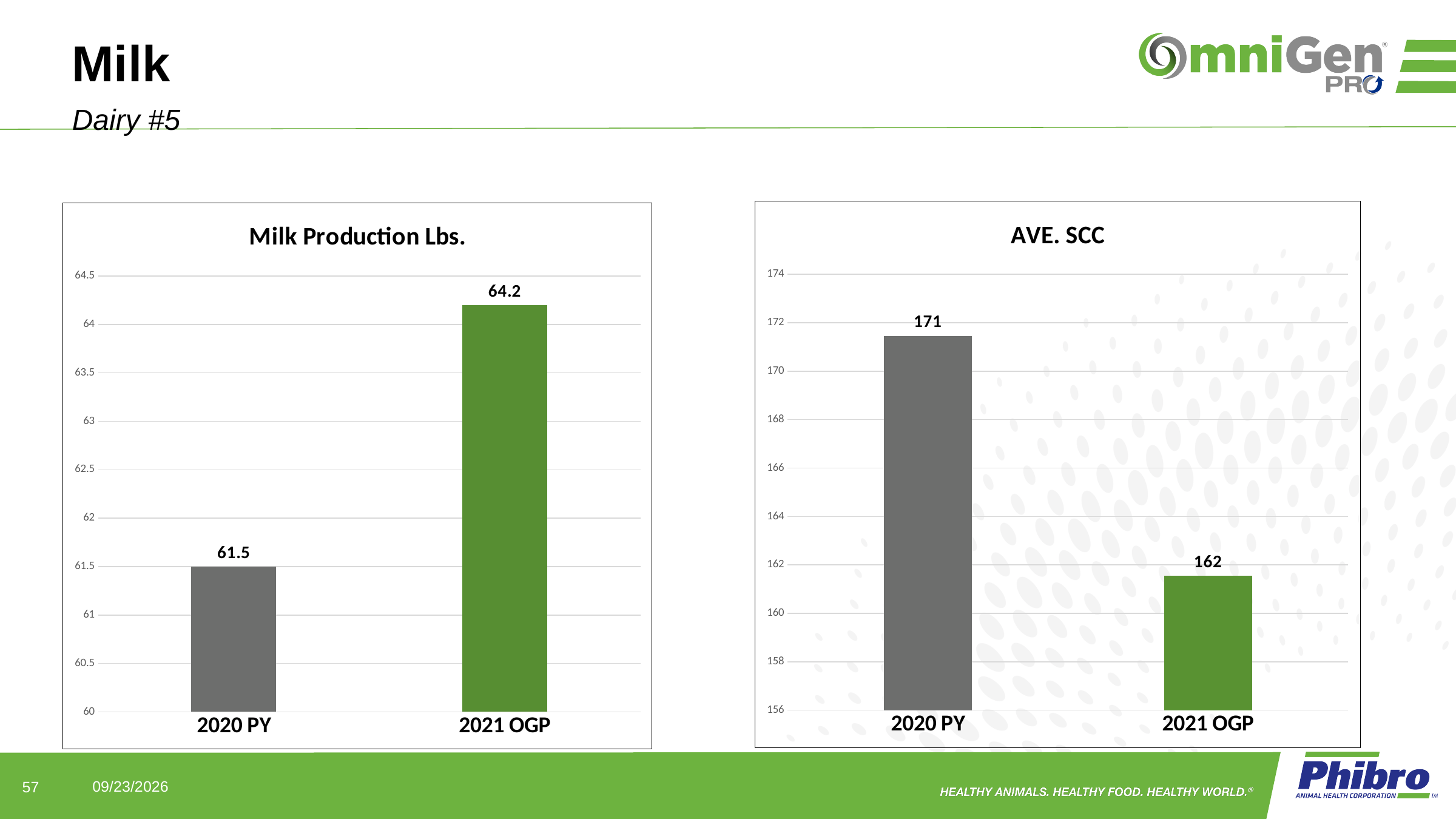
In the AVE. SCC chart, which is larger, 2020 PY or 2021 OGP? 2020 PY In the Milk Production Lbs. chart, is the value for 2021 OGP greater or less than 64? greater In the AVE. SCC chart, what is the difference between the 2020 PY and 2021 OGP values? 9 In the AVE. SCC chart, what is the value for 2021 OGP? 162 In the Milk Production Lbs. chart, what is the value for 2020 PY? 61.5 In the AVE. SCC chart, what is the value for 2020 PY? 171 In the Milk Production Lbs. chart, what is the difference between the 2021 OGP and 2020 PY values? 2.7 In the Milk Production Lbs. chart, which category has the highest value? 2021 OGP How many categories are shown in the AVE. SCC chart? 2 In the AVE. SCC chart, which category has the lowest value? 2021 OGP In the Milk Production Lbs. chart, what is the value for 2021 OGP? 64.2 What kind of chart is the Milk Production Lbs. chart? Bar chart